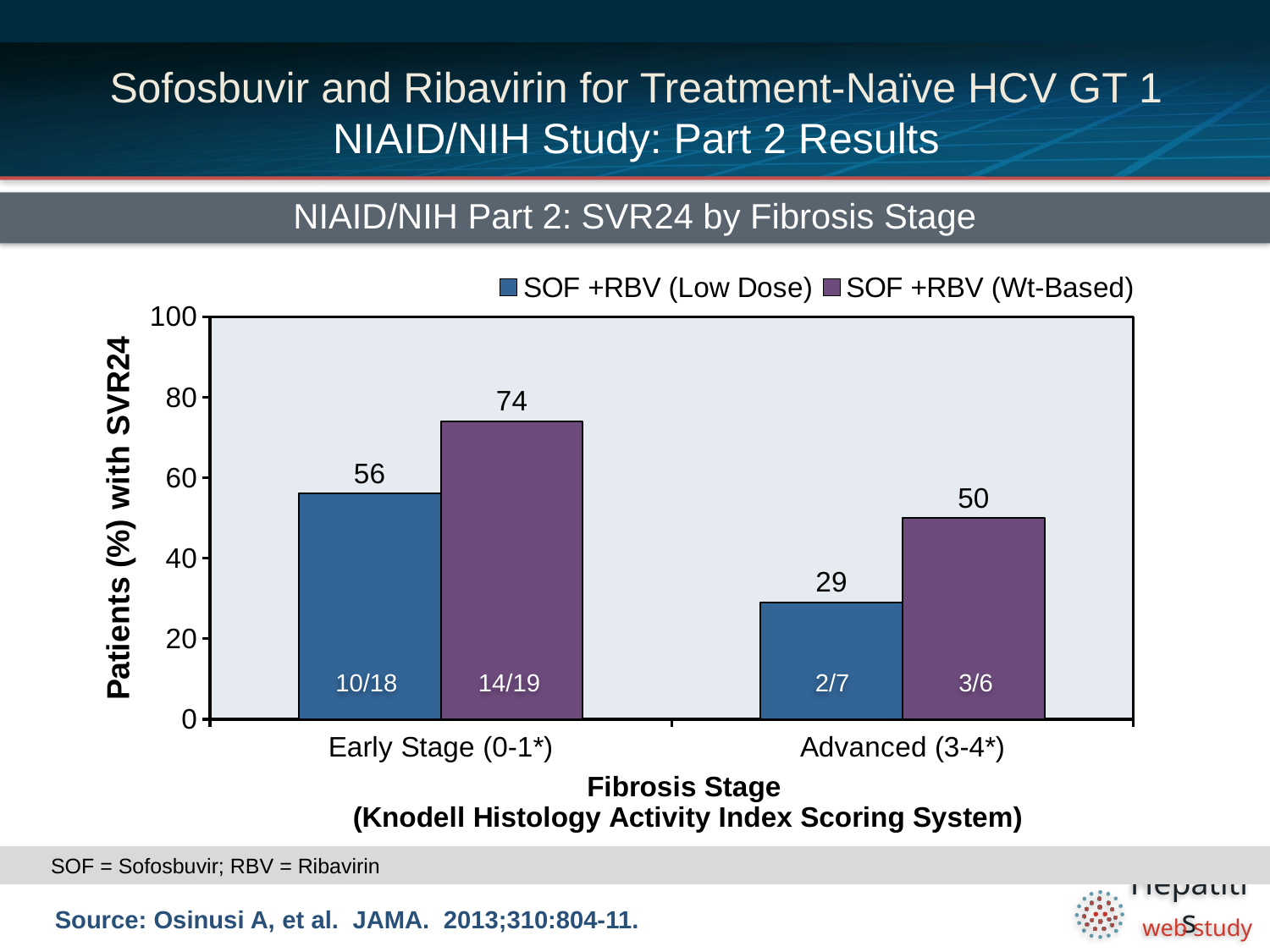
What is the SVR24 rate for SOF +RBV (Low Dose) in the Early Stage (0-1*) group? 56 How many series does the legend list? 2 Which bar has the highest SVR24 rate on the chart? SOF +RBV (Wt-Based), Early Stage (0-1*) What is the SVR24 rate for SOF +RBV (Low Dose) in the Advanced (3-4*) group? 29 What is the SVR24 rate for SOF +RBV (Wt-Based) in the Early Stage (0-1*) group? 74 What is the difference in SVR24 rate between SOF +RBV (Wt-Based) and SOF +RBV (Low Dose) in the Early Stage (0-1*) group? 18 What type of chart is shown on the slide? Bar chart Which has a higher SVR24 rate: SOF +RBV (Wt-Based) in the Advanced (3-4*) group or SOF +RBV (Low Dose) in the Early Stage (0-1*) group? SOF +RBV (Low Dose) in the Early Stage (0-1*) group What is the difference in SVR24 rate between SOF +RBV (Wt-Based) and SOF +RBV (Low Dose) in the Advanced (3-4*) group? 21 How many fibrosis stage categories are shown on the x axis? 2 What fraction of patients is shown inside the SOF +RBV (Wt-Based) bar for the Advanced (3-4*) group? 3/6 Which bar has the lowest SVR24 rate on the chart? SOF +RBV (Low Dose), Advanced (3-4*)